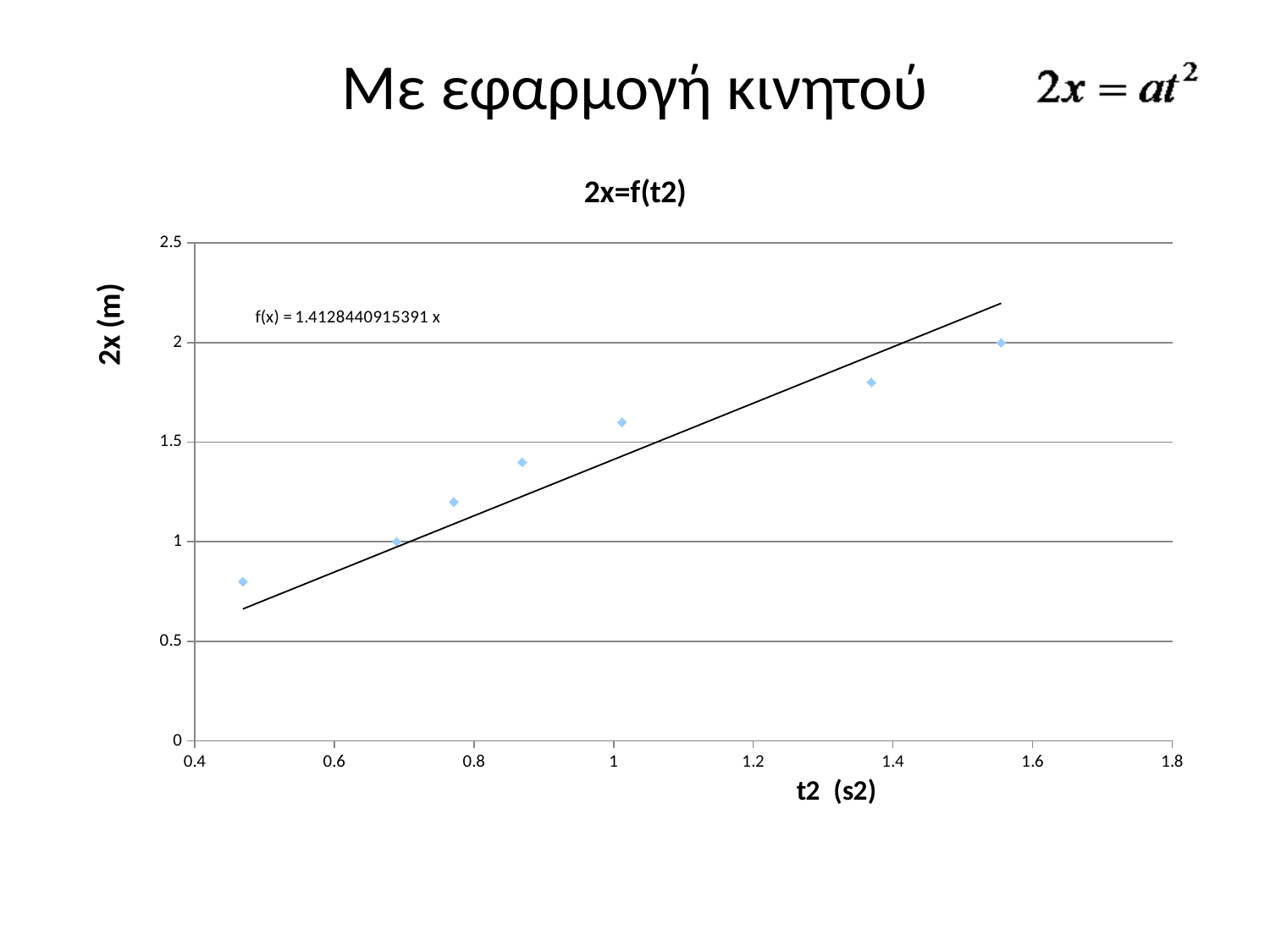
What is the 2x value of the rightmost data point, which lies on a gridline? 2 What equation is printed for the fitted line on the chart? f(x) = 1.4128440915391 x What is the title of the chart? 2x=f(t2) How many data points are plotted in the chart? 7 Is the 2x value of the data point near t2 = 1.0 greater or less than 2? less Is the 2x value of the data point near t2 = 0.8 greater or less than 1? greater Is the 2x value of the data point near t2 = 1.4 greater or less than 1.5? greater Which data point has the larger 2x value, the leftmost point or the rightmost point? the rightmost point Do the plotted 2x values rise or fall as t2 increases along the x axis? rise What kind of chart is shown on the slide? scatter chart